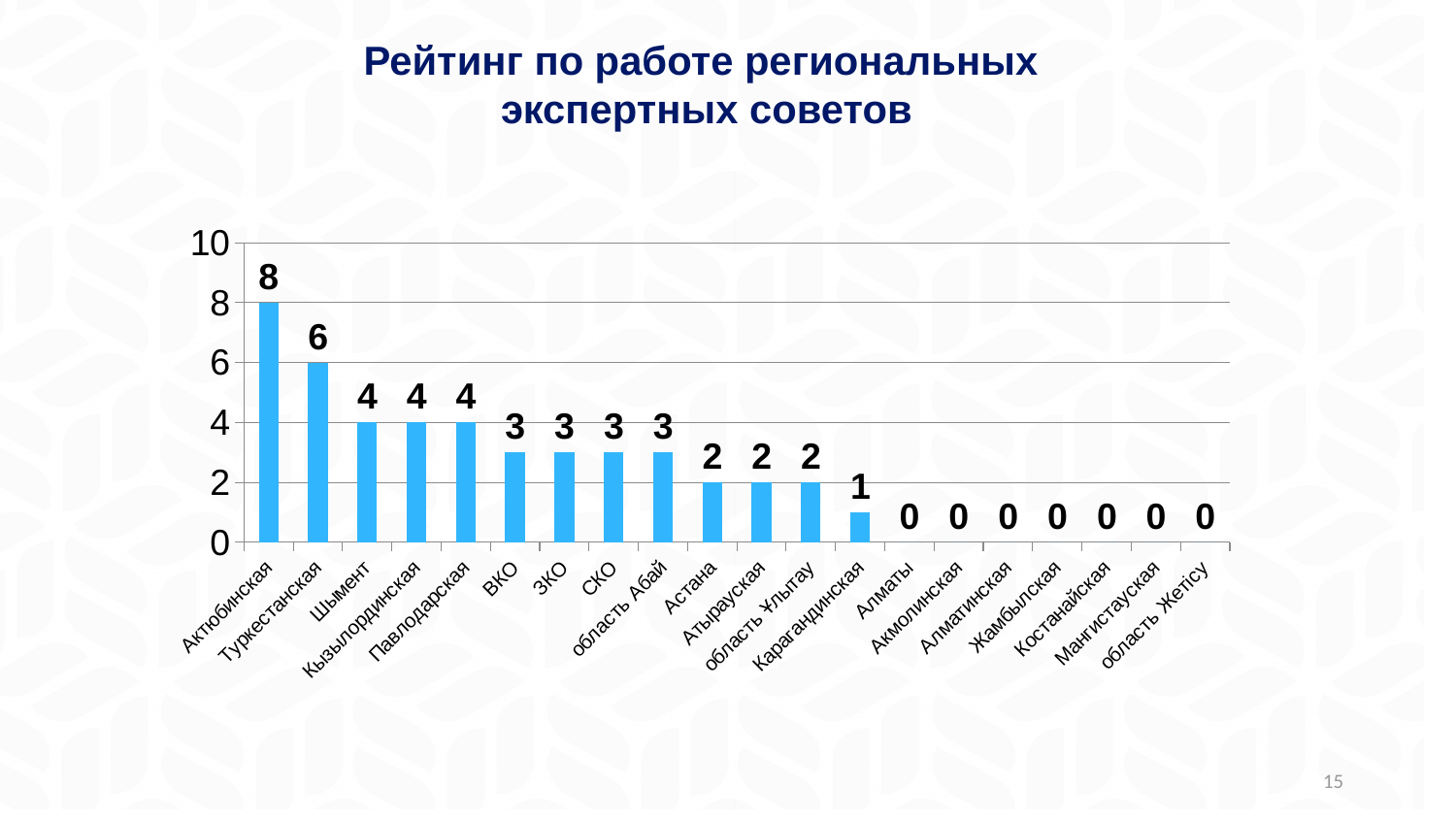
What is the difference between the values for Актюбинская and Туркестанская? 2 What is the value for Актюбинская? 8 Do the values rise or fall from left to right along the x axis? fall What is the value for область Абай? 3 What is the value for Туркестанская? 6 Which is larger, the value for Шымкент or the value for Астана? Шымкент How many categories are shown on the x axis? 20 What is the value for Карагандинская? 1 Which category has the highest value? Актюбинская Is the value for Актюбинская greater or less than 6? greater What kind of chart is shown on the slide? bar chart How many categories have a value of 0? 7